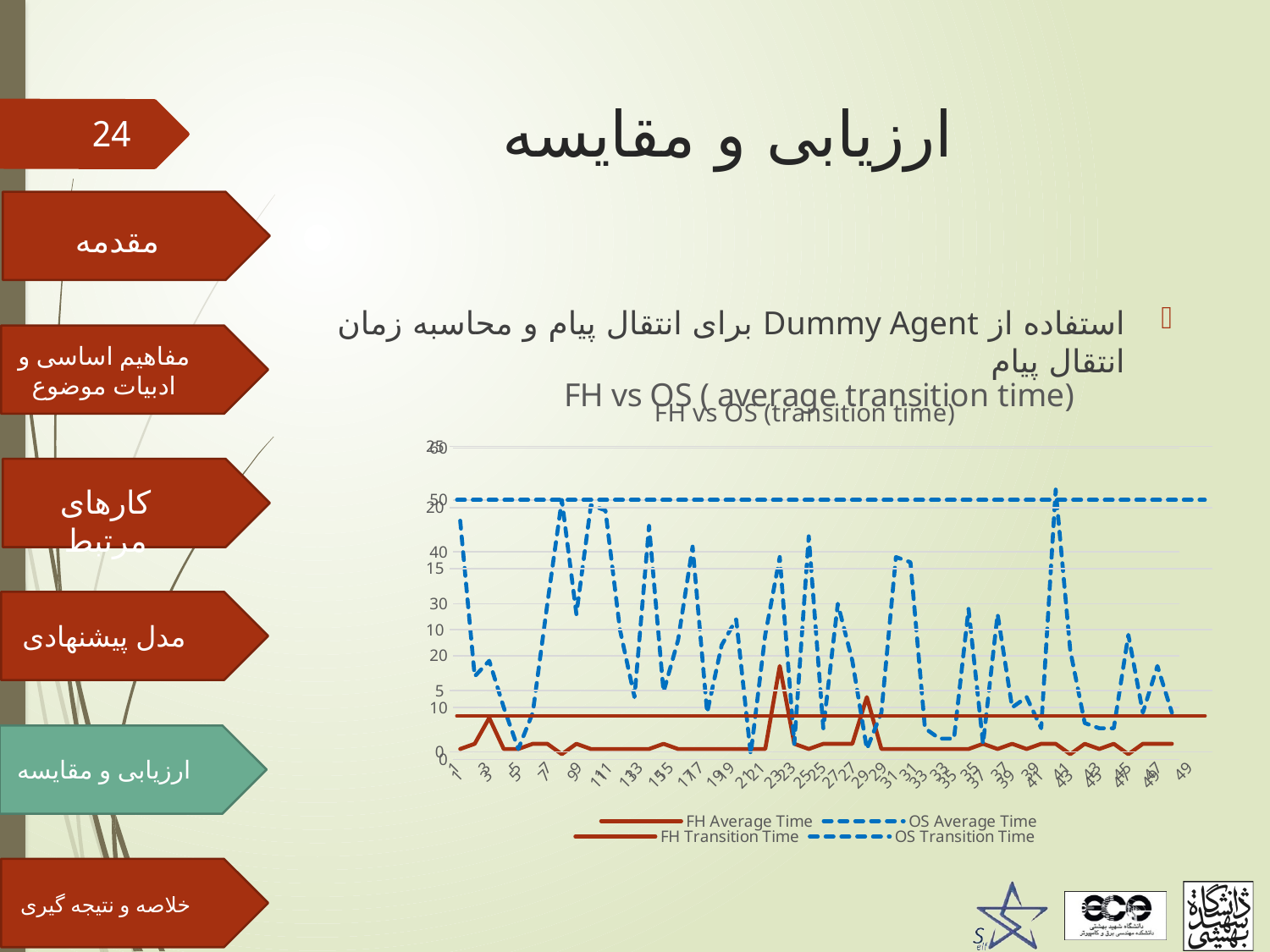
In the FH vs OS (transition time) chart, which series generally has the higher values, FH Transition Time or OS Transition Time? OS Transition Time What is the title of the chart whose title mentions transition time without the word average? FH vs OS (transition time) In the FH vs OS ( average transition time) chart, does the OS Average Time line rise, fall, or stay flat along the x axis? stay flat In the FH vs OS ( average transition time) chart, which series is higher, FH Average Time or OS Average Time? OS Average Time In the FH vs OS ( average transition time) chart, how many series does the legend list? 2 In the FH vs OS ( average transition time) chart, does the FH Average Time line rise, fall, or stay flat along the x axis? stay flat What kind of chart is used on this slide? line chart In the FH vs OS (transition time) chart, how many series does the legend list? 2 What is the title of the chart whose title mentions average transition time? FH vs OS ( average transition time) In the FH vs OS ( average transition time) chart, which series is lower, FH Average Time or OS Average Time? FH Average Time